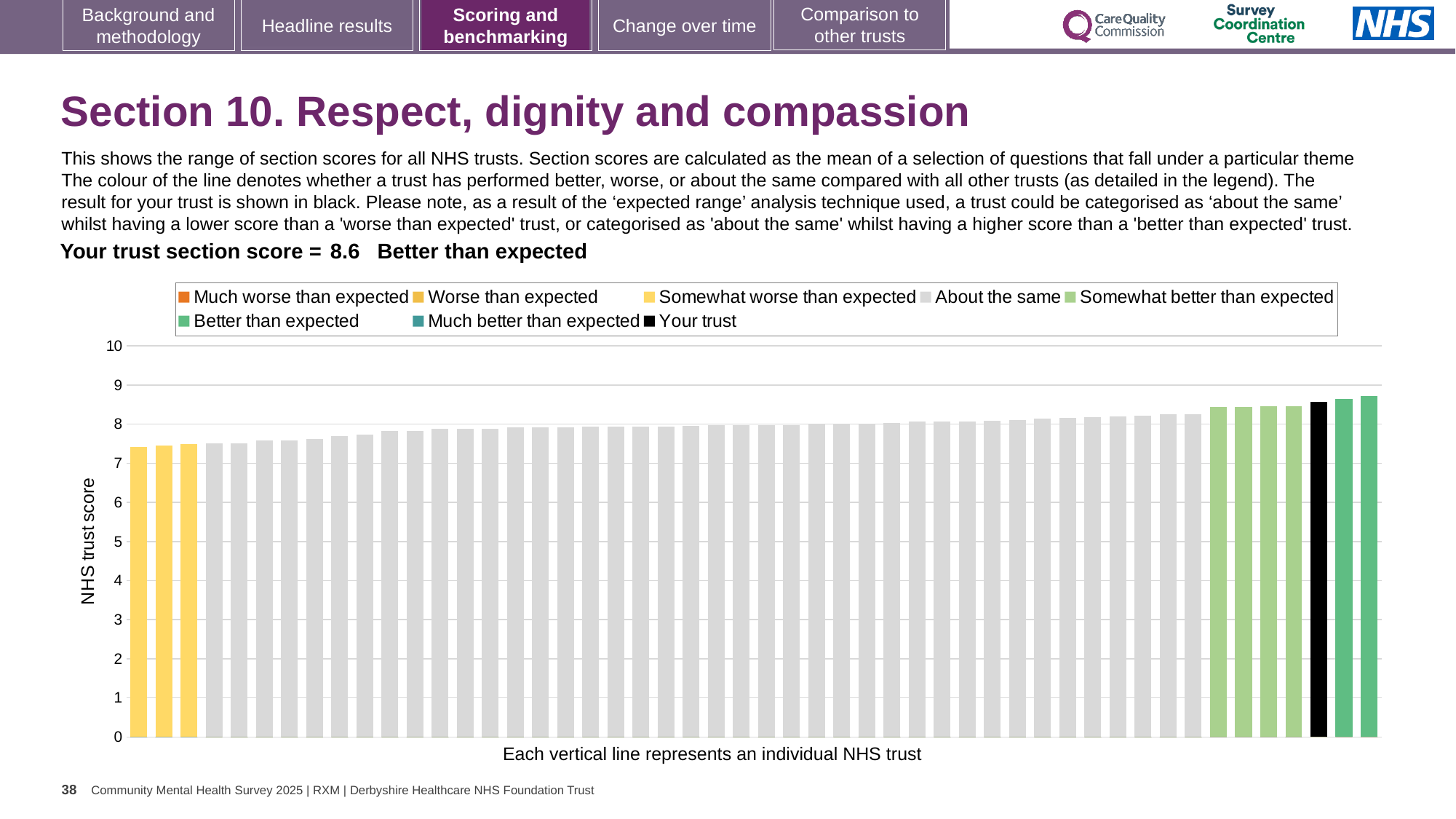
How many bars are coloured yellow (Somewhat worse than expected)? 3 Do the bar values rise or fall from left to right along the x axis? rise Is the value of the lowest bar greater or less than 8? less How many entries does the chart legend list? 8 Is the value for your trust greater or less than 8? greater What is the label of the y axis? NHS trust score What kind of chart is shown on the slide? Bar chart What is your trust's section score for Respect, dignity and compassion? 8.6 What colour is the bar representing your trust? Black What category does your trust's section score fall into according to the slide? Better than expected Is the value of the highest bar greater or less than 9? less